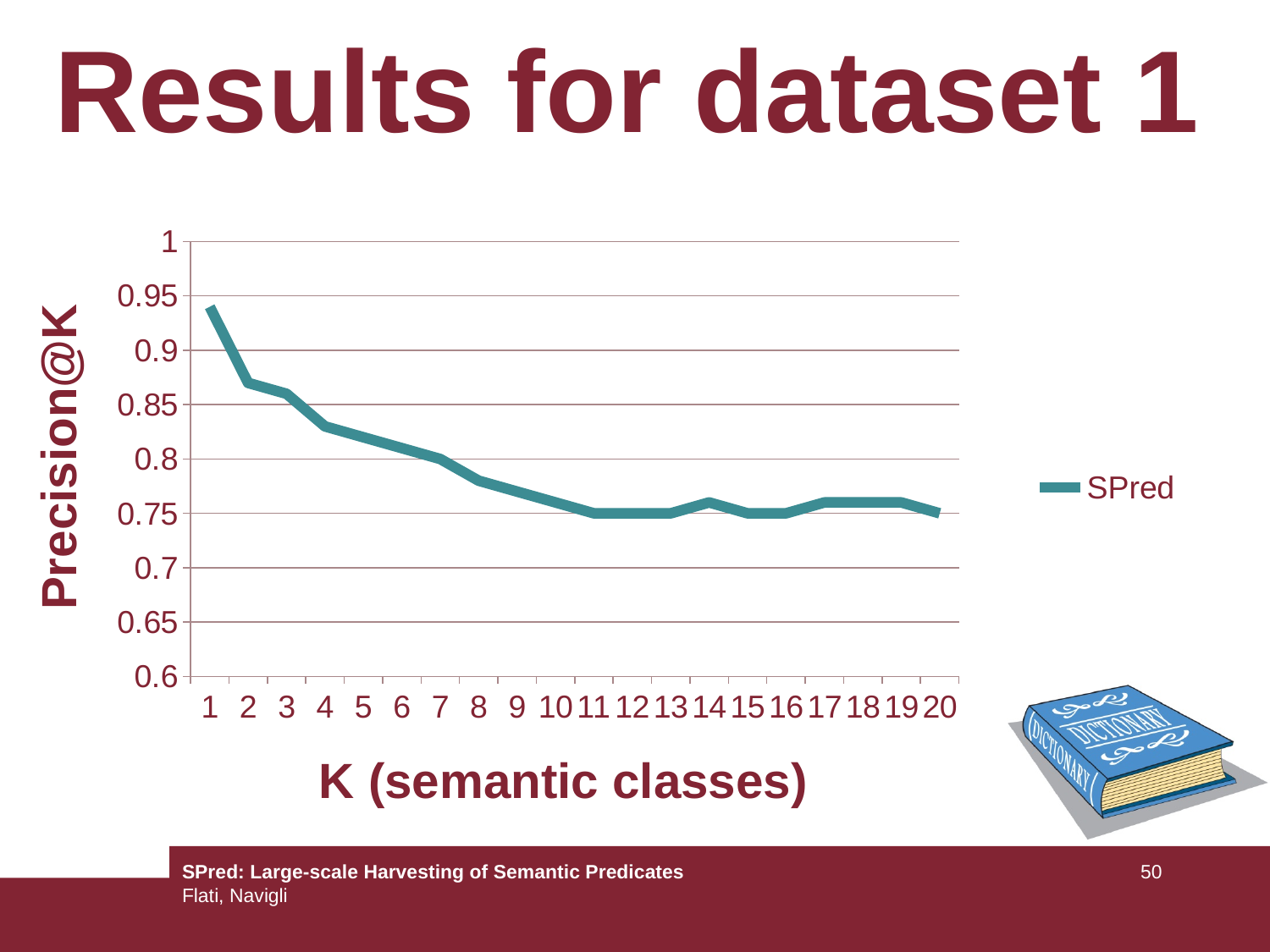
What is the label of the vertical axis? Precision@K How many values of K are plotted along the x axis? 20 Is the Precision@K value at K = 4 greater or less than 0.85? less How many series does the legend list? 1 Is the Precision@K value at K = 8 greater or less than 0.8? less Which has the higher Precision@K, K = 2 or K = 10? K = 2 Is the Precision@K value at K = 20 greater or less than 0.7? greater At which value of K is Precision@K highest? 1 What is the name of the series shown in the legend? SPred Does Precision@K generally rise or fall as K increases from 1 to 20? fall What kind of chart is shown on the slide? line chart